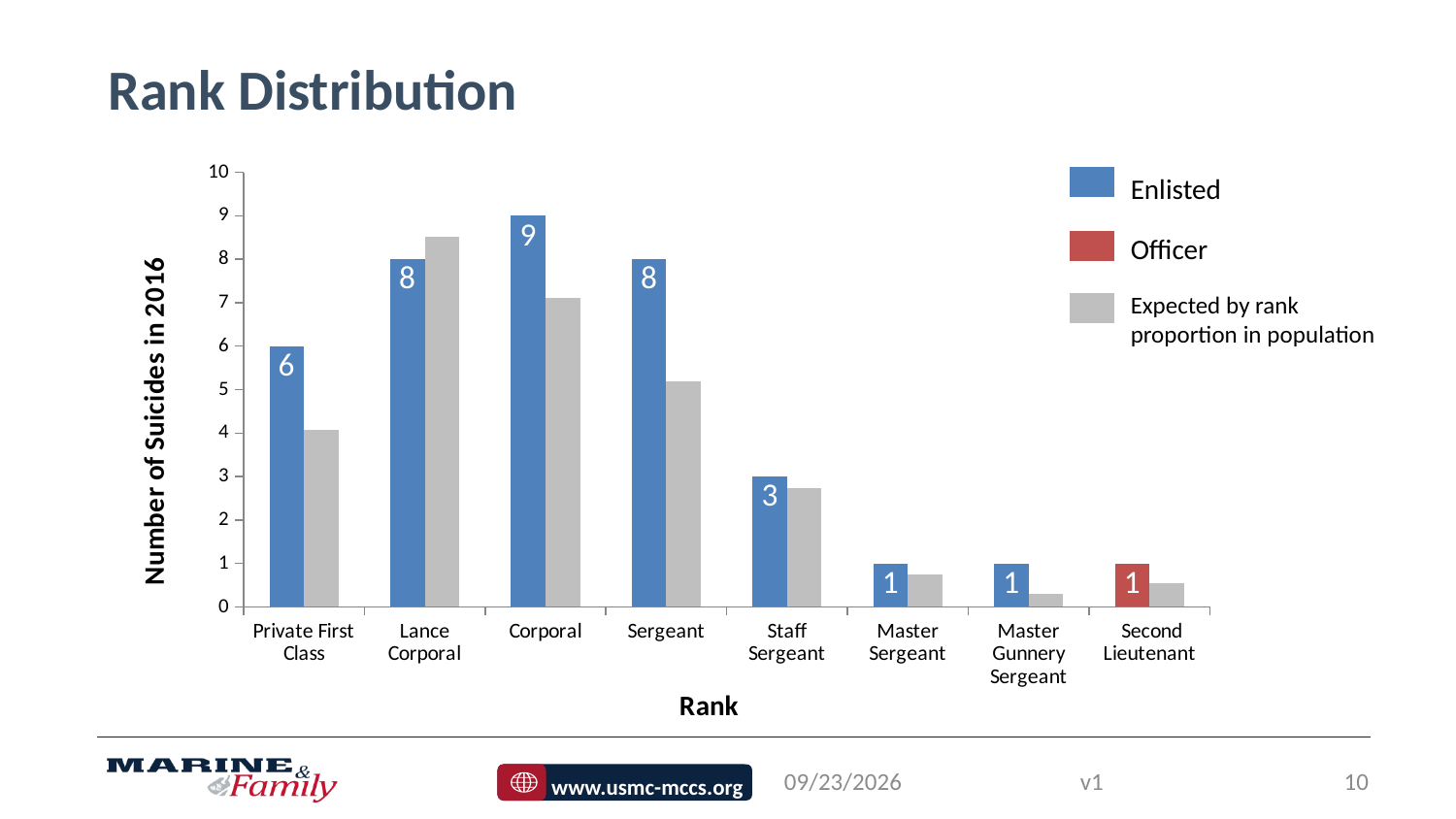
Which rank has the highest number of suicides in 2016? Corporal What is the difference between the number of suicides for Corporal and for Sergeant? 1 What type of chart is shown on the slide? bar chart How many ranks are shown on the x axis of the chart? 8 How many entries does the chart's legend list? 3 Which rank is shown with a red bar in the chart? Second Lieutenant What is the number of suicides in 2016 for Staff Sergeant? 3 What is the number of suicides in 2016 for Private First Class? 6 Is the expected value by rank proportion in population for Lance Corporal greater or less than 8? greater Which has more suicides in 2016, Private First Class or Staff Sergeant? Private First Class Is the expected value by rank proportion in population for Sergeant greater or less than 6? less What is the number of suicides in 2016 for Corporal? 9